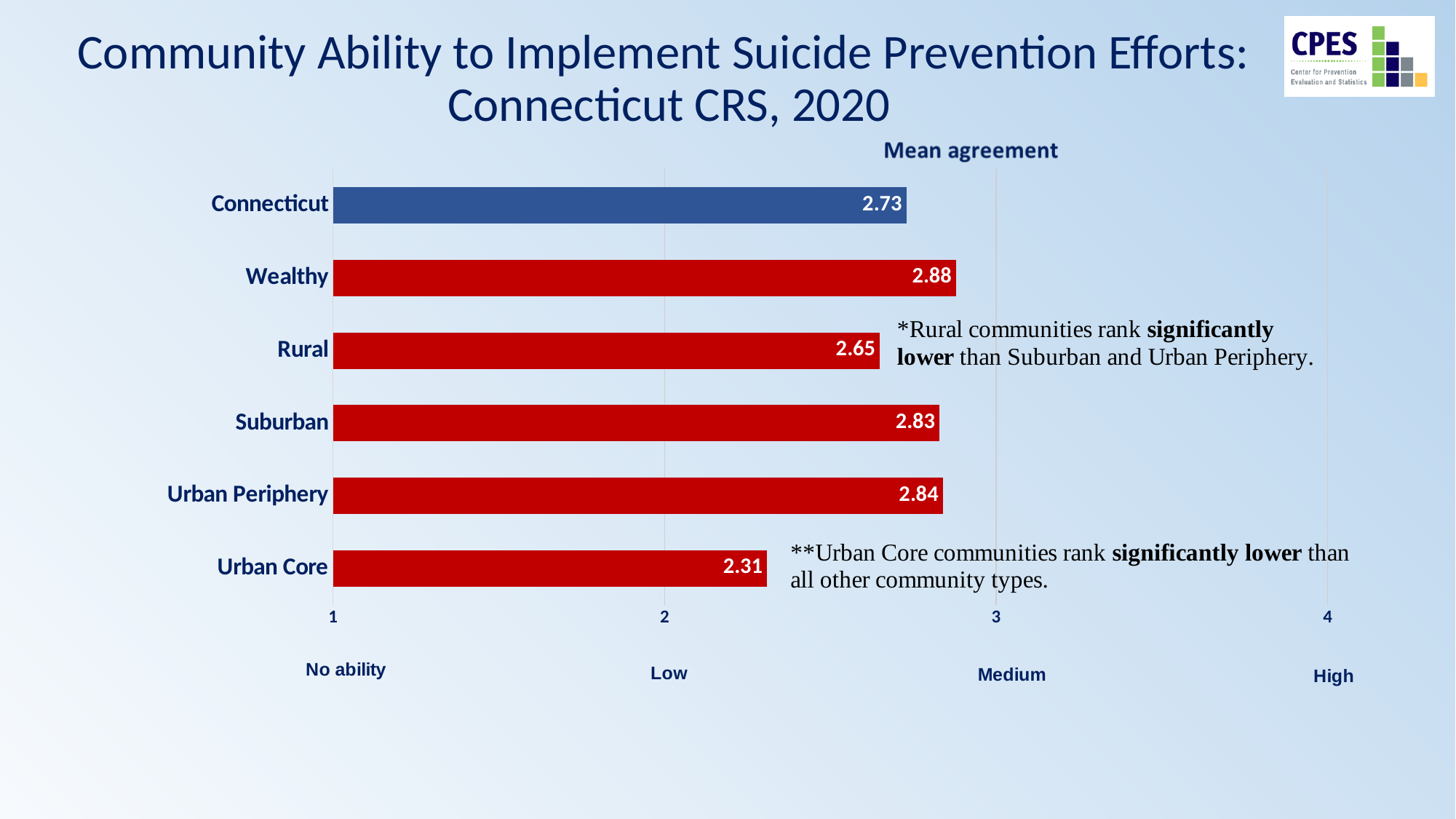
What is the mean agreement value for Suburban? 2.83 What label on the x axis corresponds to the value 3? Medium What is the mean agreement value for Urban Core? 2.31 Which has a higher mean agreement, Suburban or Rural? Suburban What is the difference between the mean agreement for Wealthy and Urban Core? 0.57 What is the mean agreement value for Connecticut? 2.73 Which category has the highest mean agreement? Wealthy What kind of chart is shown on the slide? Bar chart How many categories are shown in the chart? 6 What is the difference between the mean agreement for Connecticut and Rural? 0.08 Which category has the lowest mean agreement? Urban Core What is the mean agreement value for Rural? 2.65